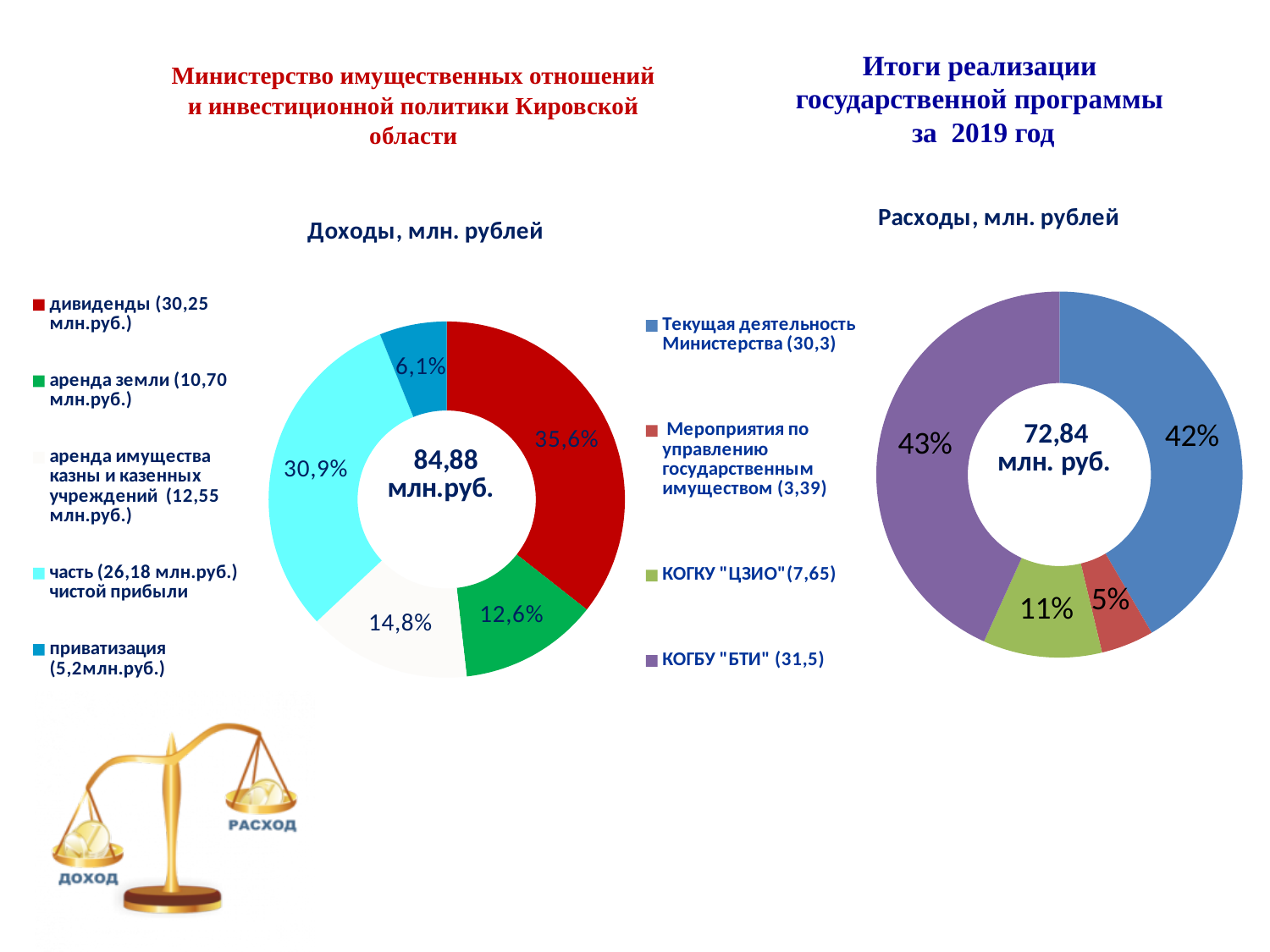
In the 'Доходы, млн. рублей' chart, what is the difference in percentage points between the shares for аренда имущества казны и казенных учреждений and аренда земли? 2,2 What type of chart is used for 'Расходы, млн. рублей'? Doughnut (pie) chart In the 'Доходы, млн. рублей' chart, what percentage share is shown for приватизация? 6,1% In the 'Доходы, млн. рублей' chart, which category has the smallest share? приватизация In the 'Расходы, млн. рублей' chart, what total value is printed in the centre of the doughnut? 72,84 млн. руб. In the 'Доходы, млн. рублей' chart, how many categories does the legend list? 5 In the 'Расходы, млн. рублей' chart, what percentage share is shown for Мероприятия по управлению государственным имуществом? 5% In the 'Доходы, млн. рублей' chart, what percentage share is shown for дивиденды? 35,6% In the 'Доходы, млн. рублей' chart, which category has the largest share? дивиденды In the 'Расходы, млн. рублей' chart, what percentage share is shown for КОГБУ "БТИ"? 43% In the 'Доходы, млн. рублей' chart, what total value is printed in the centre of the doughnut? 84,88 млн.руб. In the 'Расходы, млн. рублей' chart, which is larger: the share for Текущая деятельность Министерства or the share for КОГКУ "ЦЗИО"? Текущая деятельность Министерства